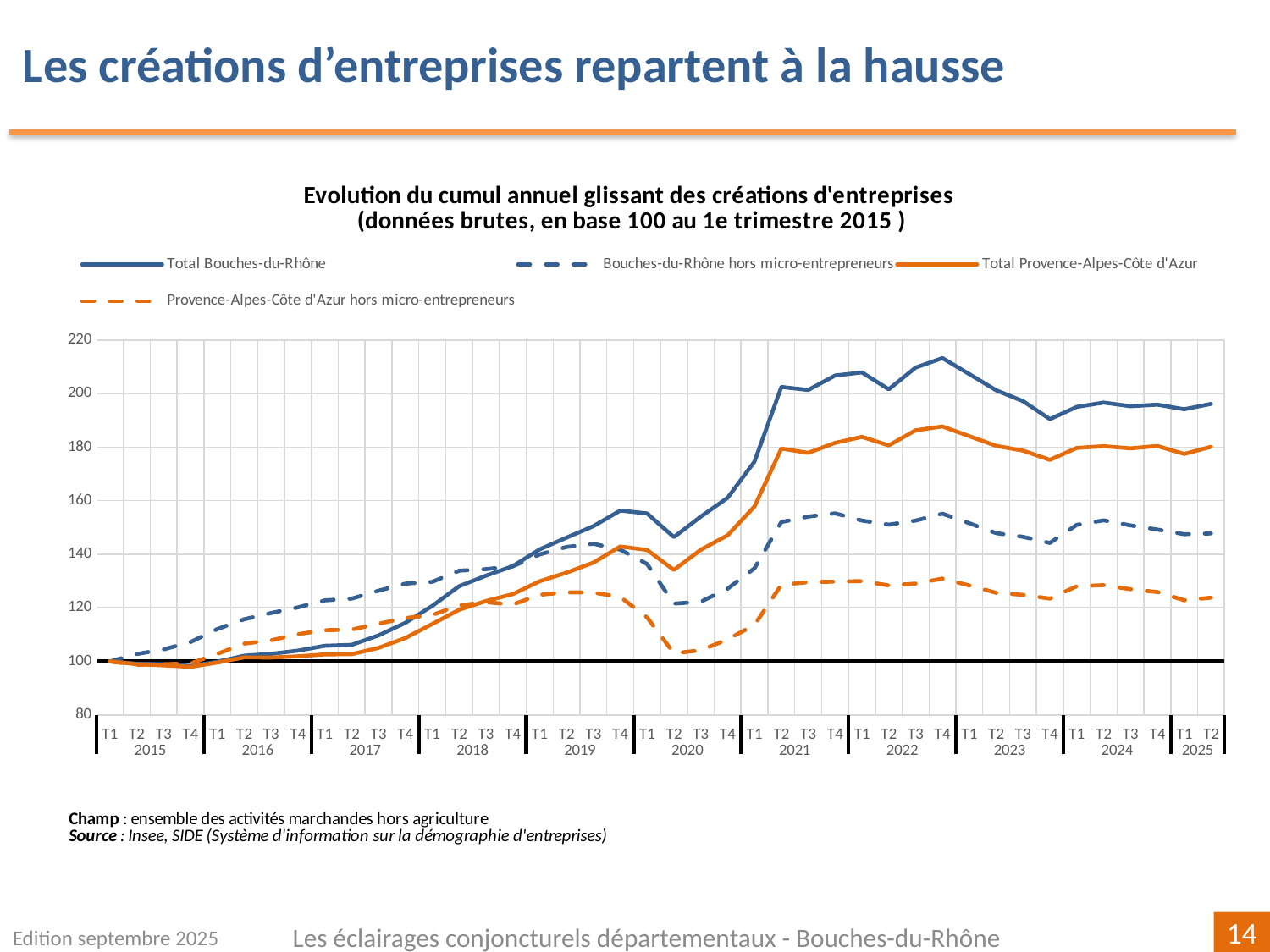
What kind of chart is shown on the slide? line chart Is the value for Provence-Alpes-Côte d'Azur hors micro-entrepreneurs at T3 2020 greater or less than 120? less Is the value for Bouches-du-Rhône hors micro-entrepreneurs at T2 2025 greater or less than 140? greater Which series has the highest value at T2 2025? Total Bouches-du-Rhône Does the Provence-Alpes-Côte d'Azur hors micro-entrepreneurs series rise or fall between T4 2019 and T3 2020? fall Which series has the lowest value at T2 2025? Provence-Alpes-Côte d'Azur hors micro-entrepreneurs Which series is drawn as a solid orange line? Total Provence-Alpes-Côte d'Azur Does the Total Bouches-du-Rhône series rise or fall between T1 2015 and T4 2022? rise Is the value for Total Bouches-du-Rhône at T4 2022 greater or less than 200? greater What is the title of the chart? Evolution du cumul annuel glissant des créations d'entreprises (données brutes, en base 100 au 1e trimestre 2015 ) How many series does the legend list? 4 At T4 2022, which is larger: Total Bouches-du-Rhône or Total Provence-Alpes-Côte d'Azur? Total Bouches-du-Rhône